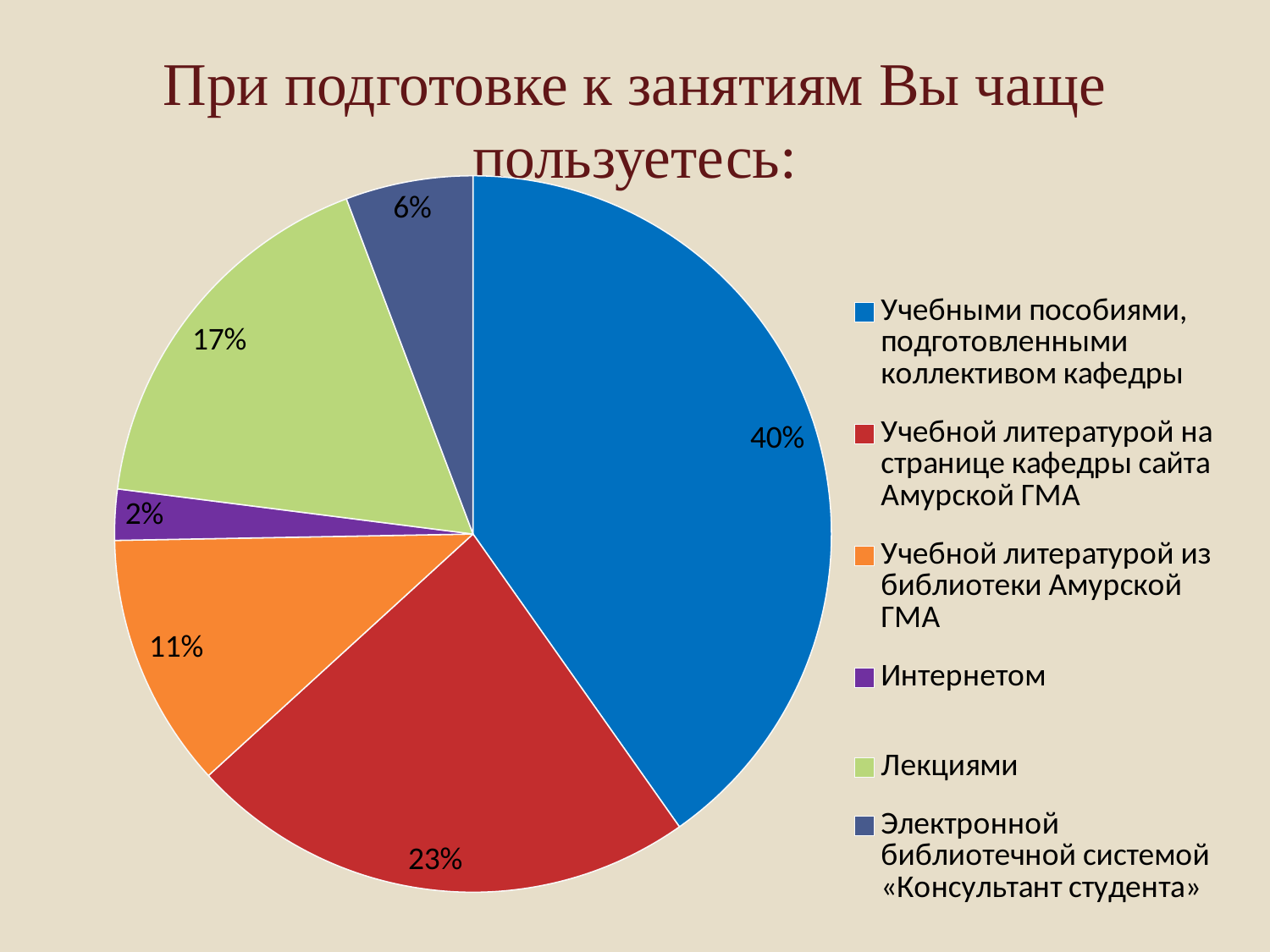
Which category has the largest slice of the pie? Учебными пособиями, подготовленными коллективом кафедры Which is larger: the share for «Лекциями» or the share for «Учебной литературой из библиотеки Амурской ГМА»? Лекциями Which category has the smallest slice of the pie? Интернетом How many categories does the legend list? 6 What share of the pie is labelled for «Учебной литературой на странице кафедры сайта Амурской ГМА»? 23% What share of the pie is labelled for «Учебными пособиями, подготовленными коллективом кафедры»? 40% What share of the pie is labelled for «Электронной библиотечной системой «Консультант студента»»? 6% What is the difference between the shares for «Учебными пособиями, подготовленными коллективом кафедры» and «Учебной литературой на странице кафедры сайта Амурской ГМА»? 17% What share of the pie is labelled for «Лекциями»? 17% What share of the pie is labelled for «Интернетом»? 2% What type of chart is shown on the slide? pie chart What colour is the slice for «Учебной литературой из библиотеки Амурской ГМА»? orange